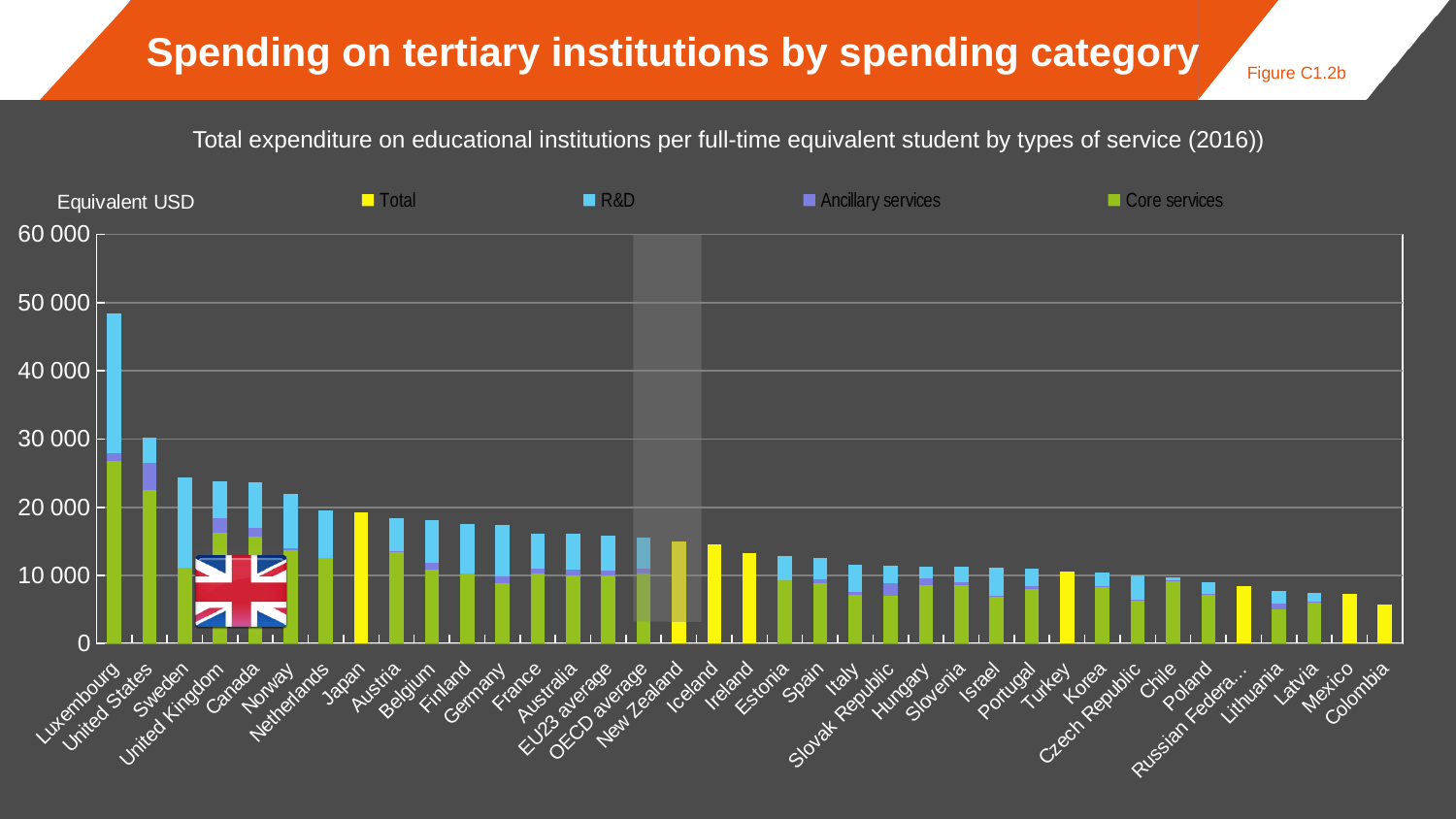
Do the total values generally rise or fall moving from left to right along the x axis? fall How many series does the legend list? 4 Is the total value for Colombia greater or less than 10 000? less Is the total value for Luxembourg greater or less than 40 000? greater Which country has the lowest total expenditure per full-time equivalent student? Colombia Which has a larger total expenditure, Luxembourg or the United States? Luxembourg What unit is shown on the vertical axis label? Equivalent USD Which country has the highest total expenditure per full-time equivalent student? Luxembourg Is the total value for Iceland greater or less than 10 000? greater Which has a larger total expenditure, Japan or Mexico? Japan What kind of chart is shown on the slide? Stacked bar chart